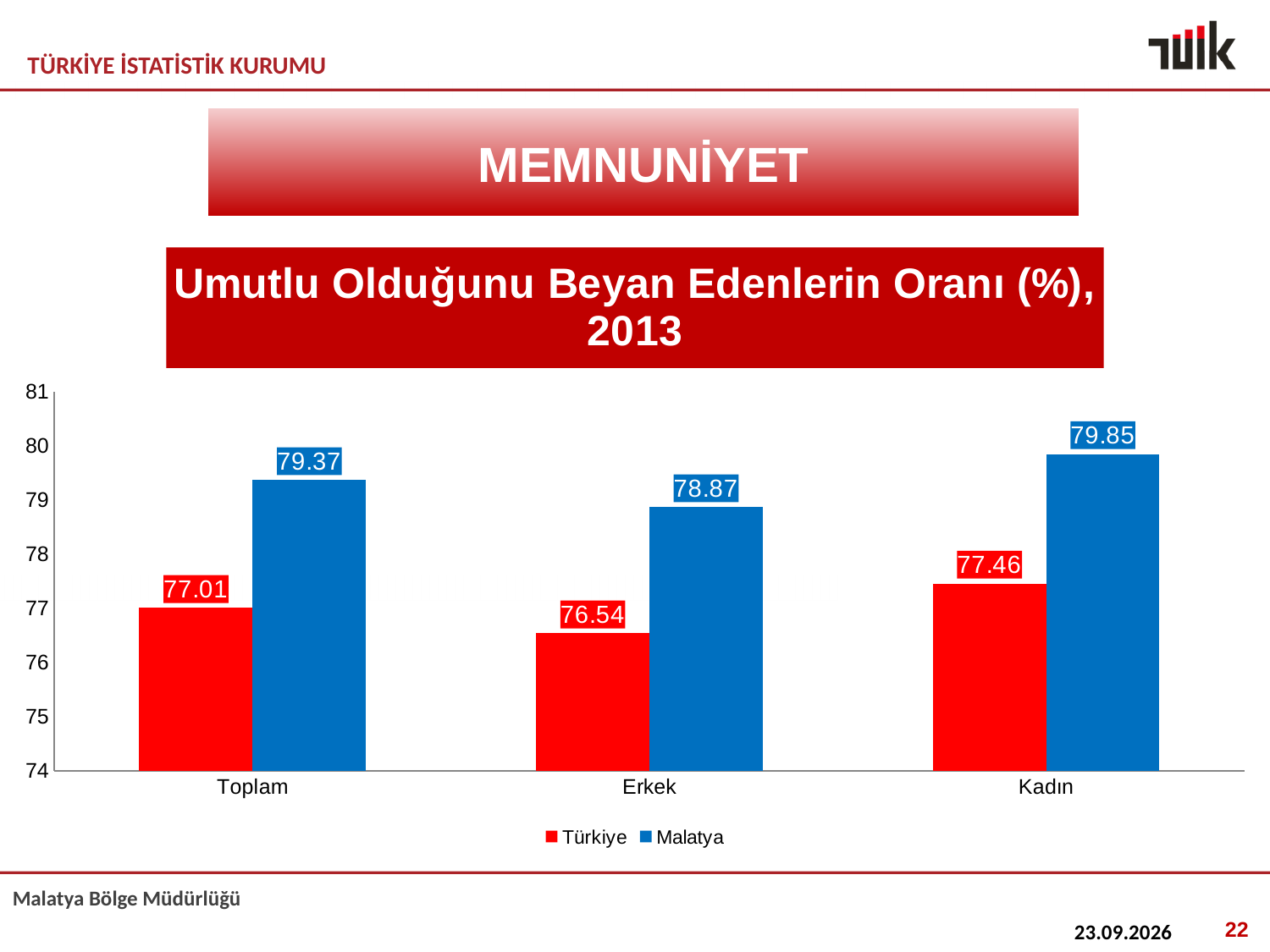
How many categories are shown on the x axis? 3 Which category has the lowest Türkiye value? Erkek Which category has the highest Malatya value? Kadın Is the Malatya value for Toplam greater or less than 79? greater What is the value for Türkiye in the Toplam category? 77.01 What is the value for Malatya in the Kadın category? 79.85 What kind of chart is shown on the slide? bar chart What is the difference between the Malatya and Türkiye values for Toplam? 2.36 What is the difference between the Türkiye values for Kadın and Erkek? 0.92 What is the value for Malatya in the Erkek category? 78.87 Which is larger in the Erkek category, Türkiye or Malatya? Malatya How many series does the legend list? 2